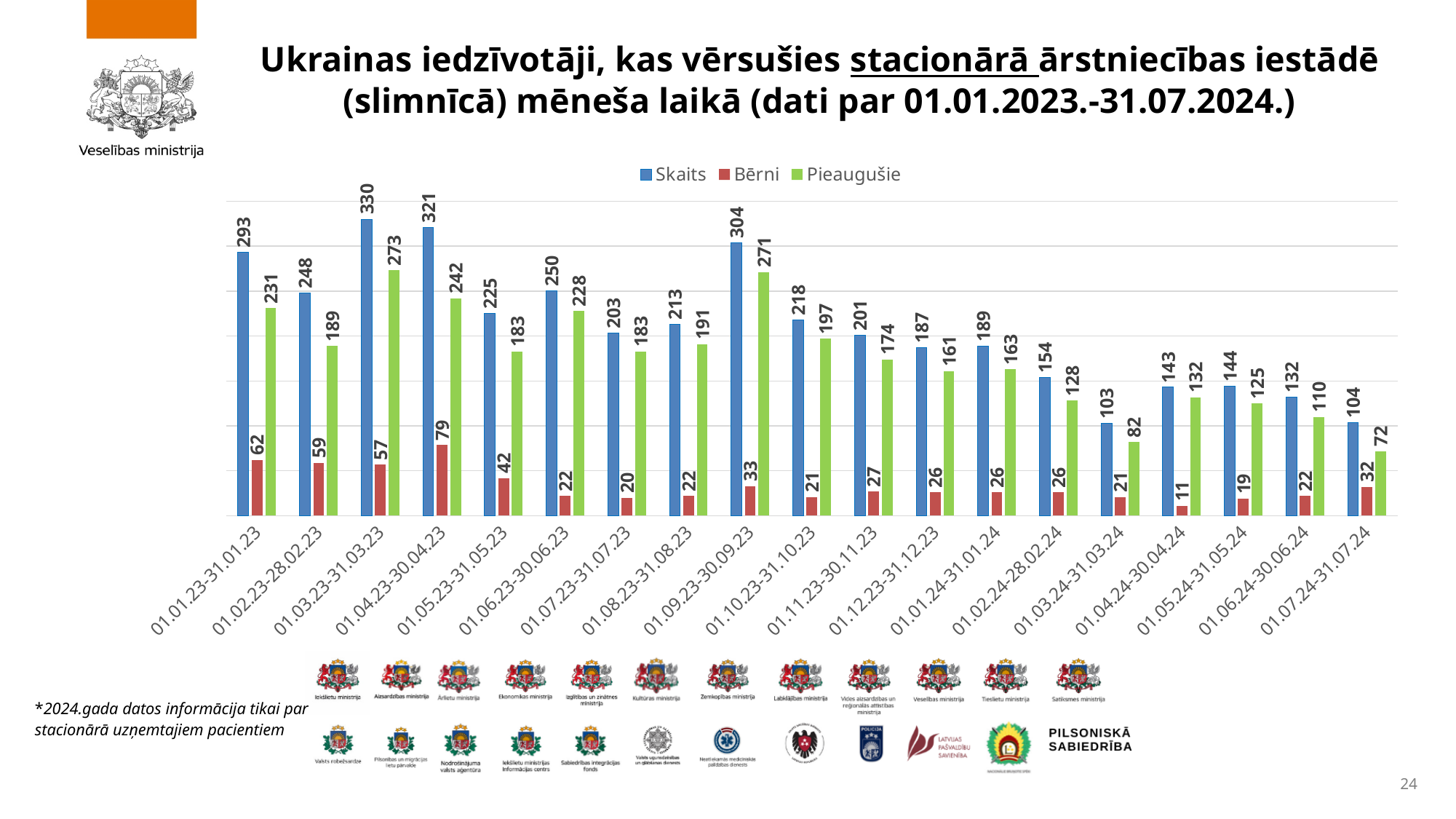
Which period has the highest Skaits value? 01.03.23-31.03.23 What is the Pieaugušie value for 01.09.23-30.09.23? 271 Which is larger: the Pieaugušie value for 01.06.23-30.06.23 or for 01.08.23-31.08.23? 01.06.23-30.06.23 Which period has the lowest Bērni value? 01.04.24-30.04.24 Which series is shown in green in the legend? Pieaugušie How many series does the legend list? 3 What is the Skaits value for 01.03.23-31.03.23? 330 What is the Bērni value for 01.04.23-30.04.23? 79 What kind of chart is shown on the slide? bar chart How many periods are shown on the x axis? 19 What is the difference between the Skaits values for 01.01.23-31.01.23 and 01.02.23-28.02.23? 45 Which period has the lowest Skaits value? 01.03.24-31.03.24